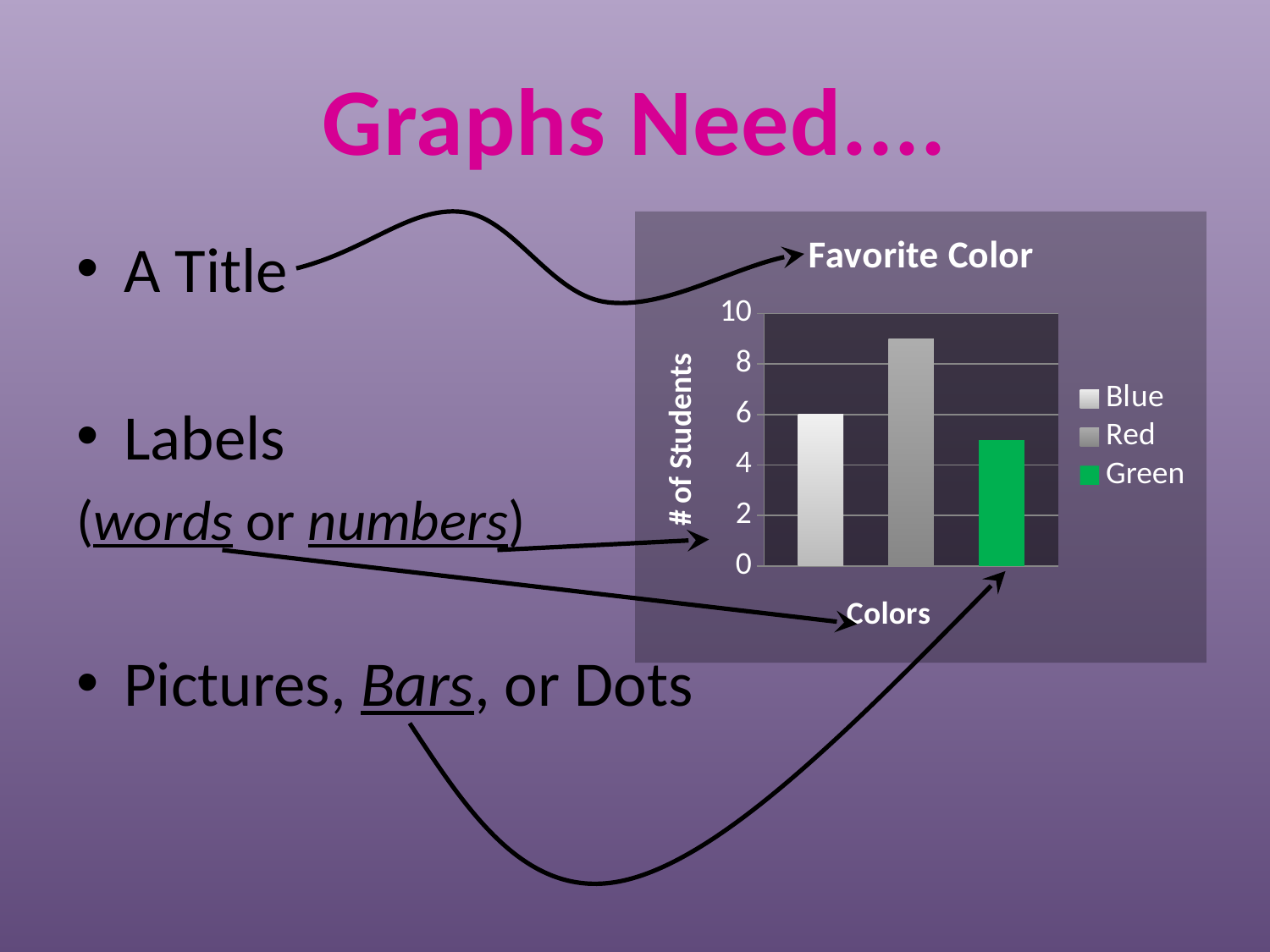
How many bars are plotted in the chart? 3 What is the title of the chart? Favorite Color Which color has the lowest number of students? Green What kind of chart is shown on the slide? bar chart Which is larger, the value for Red or the value for Blue? Red Which color has the highest number of students? Red Is the value for Red greater or less than 8? greater Is the value for Green greater or less than 6? less How many entries does the chart's legend list? 3 What is the value for Blue in the chart? 6 What is the label on the vertical axis of the chart? # of Students Which is larger, the value for Blue or the value for Green? Blue